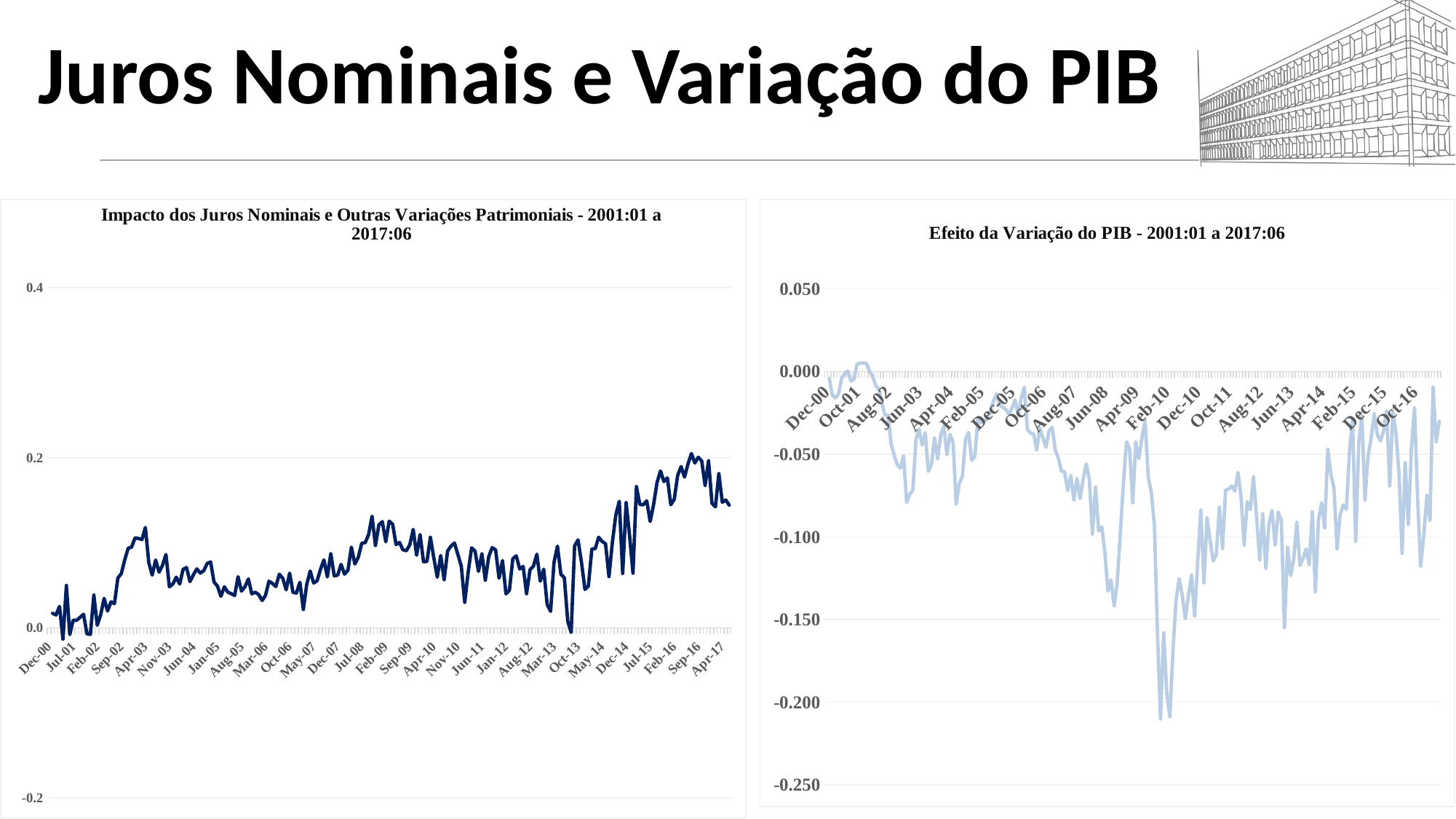
In the left chart, is the value for Feb-09 greater or less than 0.0? greater In the left chart, is the value for Feb-09 greater or less than 0.2? less What kind of chart is the right chart, 'Efeito da Variação do PIB'? Line chart What period does the left chart's title say it covers? 2001:01 a 2017:06 In the right chart, does the line overall rise or fall from Dec-00 to Feb-10? fall What is the title of the right chart? Efeito da Variação do PIB - 2001:01 a 2017:06 What kind of chart is the left chart, 'Impacto dos Juros Nominais e Outras Variações Patrimoniais'? Line chart In the left chart, is the value for Apr-17 greater or less than 0.2? less In the left chart, does the line overall rise or fall from Dec-00 to Sep-16? rise